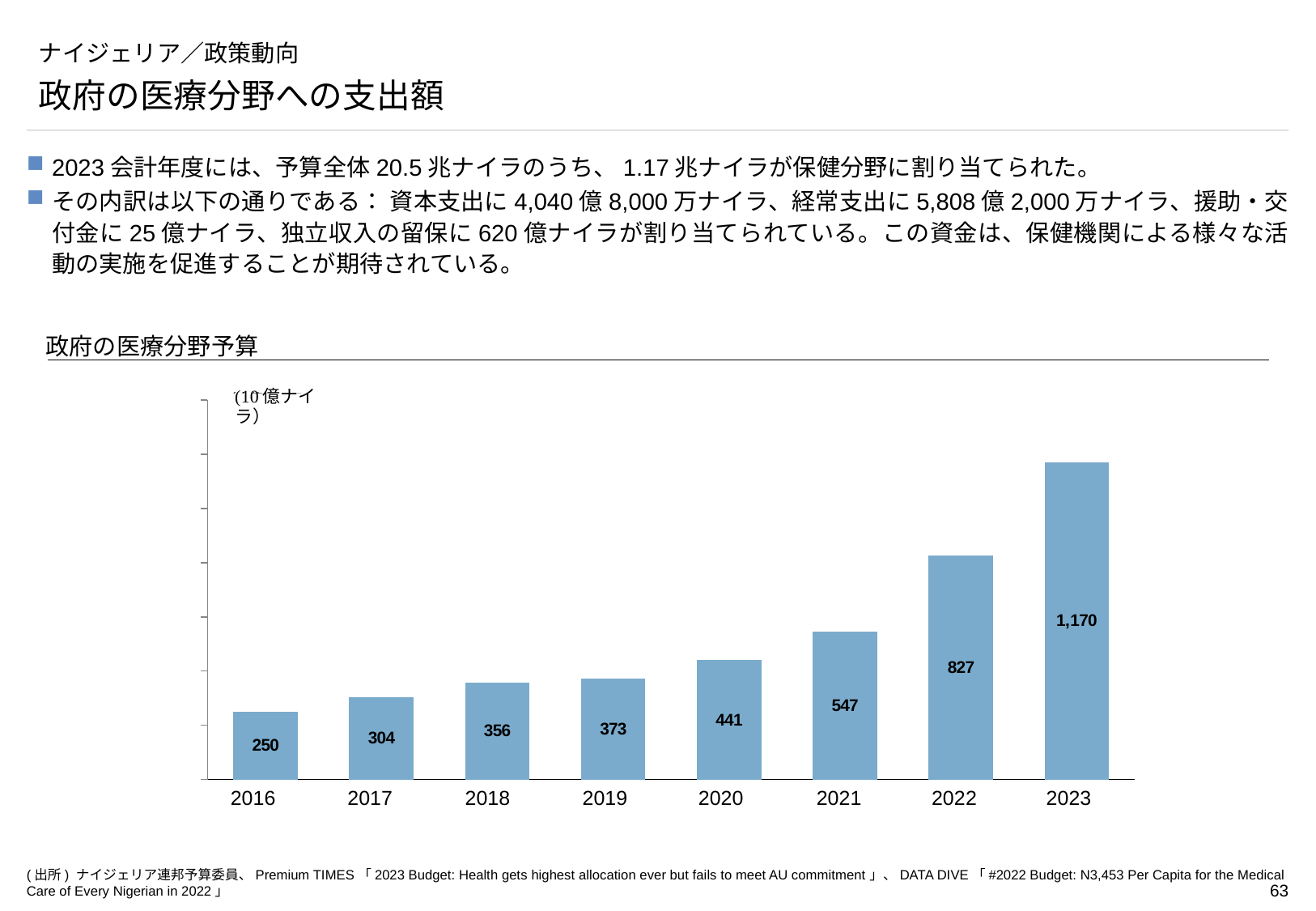
What is the value for 2023 in the 政府の医療分野予算 chart? 1,170 Do the values in the 政府の医療分野予算 chart rise or fall from 2016 to 2023? rise What is the value for 2016 in the 政府の医療分野予算 chart? 250 What is the value for 2020 in the 政府の医療分野予算 chart? 441 Which year has the highest value in the 政府の医療分野予算 chart? 2023 Which year has the lowest value in the 政府の医療分野予算 chart? 2016 What is the difference between the 2021 and 2020 values in the 政府の医療分野予算 chart? 106 Which is larger in the 政府の医療分野予算 chart, the value for 2019 or the value for 2018? 2019 What kind of chart is the 政府の医療分野予算 chart? bar chart How many years are shown in the 政府の医療分野予算 chart? 8 What unit is shown on the 政府の医療分野予算 chart? 10億ナイラ What is the difference between the 2023 and 2022 values in the 政府の医療分野予算 chart? 343